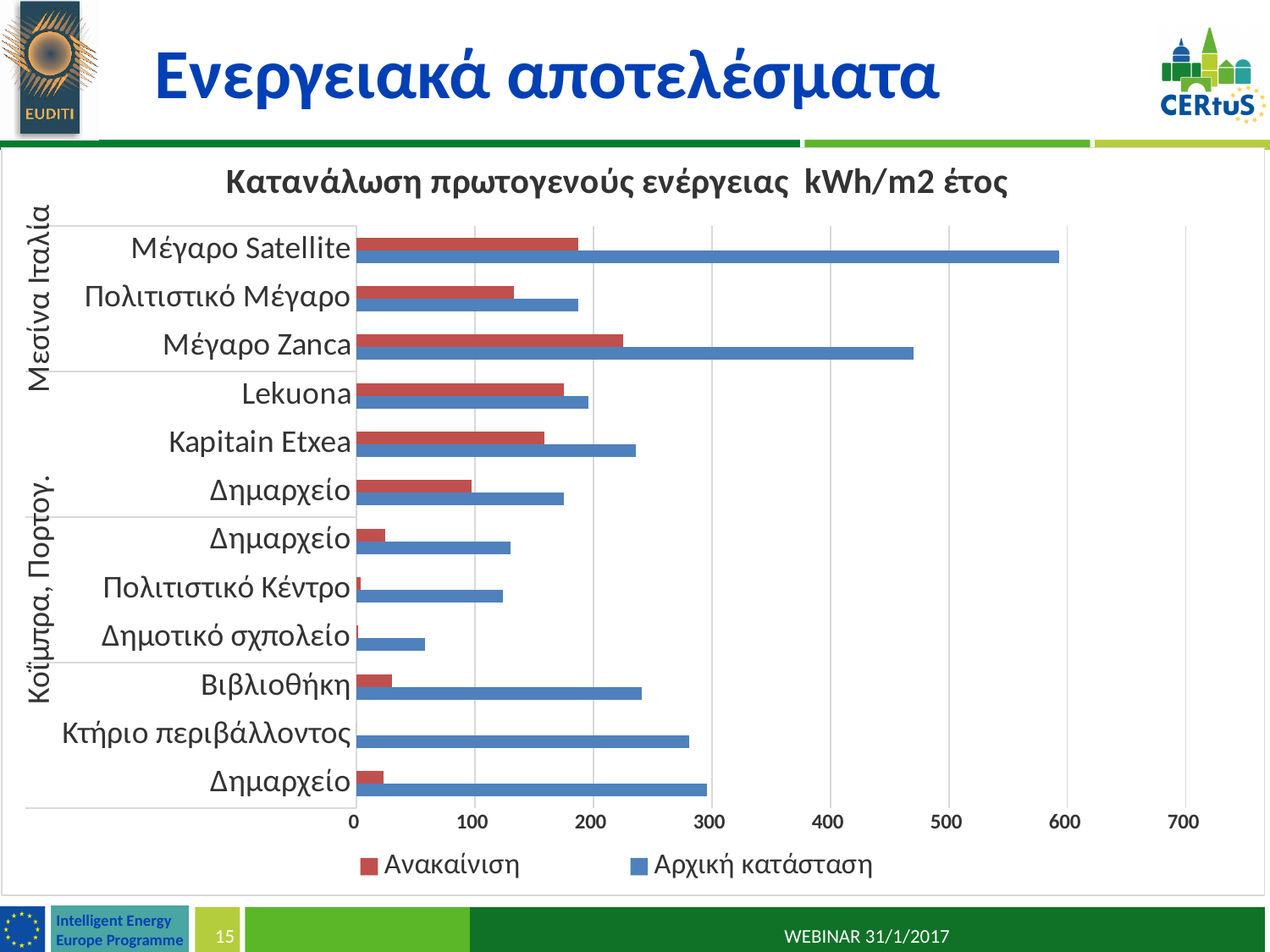
Is the Ανακαίνιση value for Lekuona greater or less than 100? greater Is the Αρχική κατάσταση value for Μέγαρο Satellite greater or less than 500? greater What is the title of the chart? Κατανάλωση πρωτογενούς ενέργειας kWh/m2 έτος Which building has the lowest Αρχική κατάσταση value? Δημοτικό σχπολείο Which is larger, the Αρχική κατάσταση value for Μέγαρο Satellite or for Μέγαρο Zanca? Μέγαρο Satellite Is the Αρχική κατάσταση value for Κτήριο περιβάλλοντος greater or less than 300? less Which building has the highest Ανακαίνιση value? Μέγαρο Zanca How many building categories are plotted on the chart? 12 What kind of chart is shown on the slide? Bar chart How many series does the legend list? 2 Which building has the highest Αρχική κατάσταση value? Μέγαρο Satellite